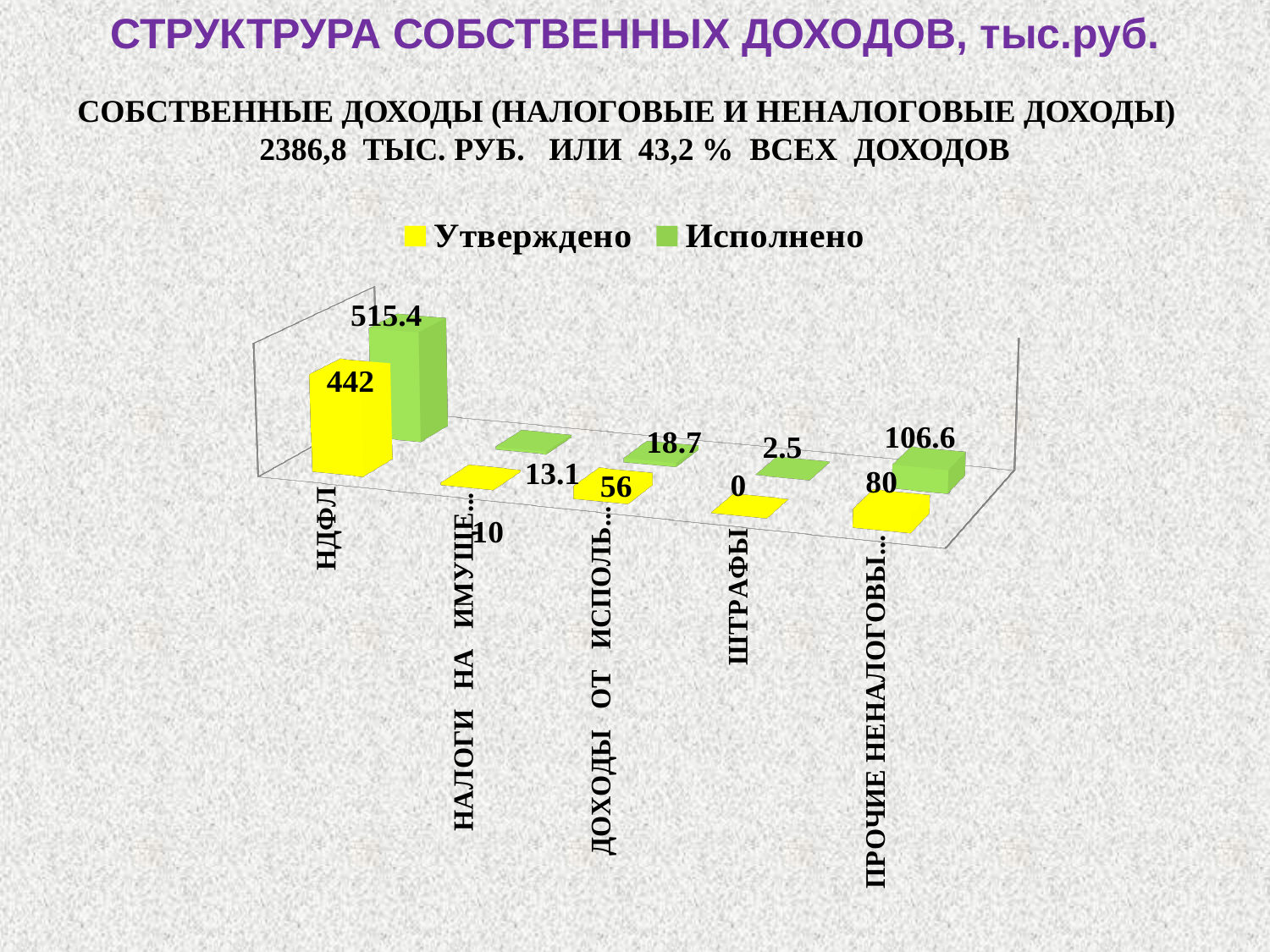
What is the difference between the Исполнено and Утверждено values for НДФЛ? 73.4 What is the Утверждено value for НДФЛ? 442 What is the Исполнено value for ШТРАФЫ? 2.5 How many series does the legend list? 2 What kind of chart is shown on the slide? Bar chart What is the Утверждено value for ШТРАФЫ? 0 Which category has the lowest Утверждено value? ШТРАФЫ For the category labelled ДОХОДЫ ОТ ИСПОЛЬ..., which is larger: Утверждено or Исполнено? Утверждено How many categories are shown on the chart? 5 What is the Исполнено value for НДФЛ? 515.4 Which category has the highest Исполнено value? НДФЛ What is the Исполнено value for the category labelled ПРОЧИЕ НЕНАЛОГОВЫ...? 106.6